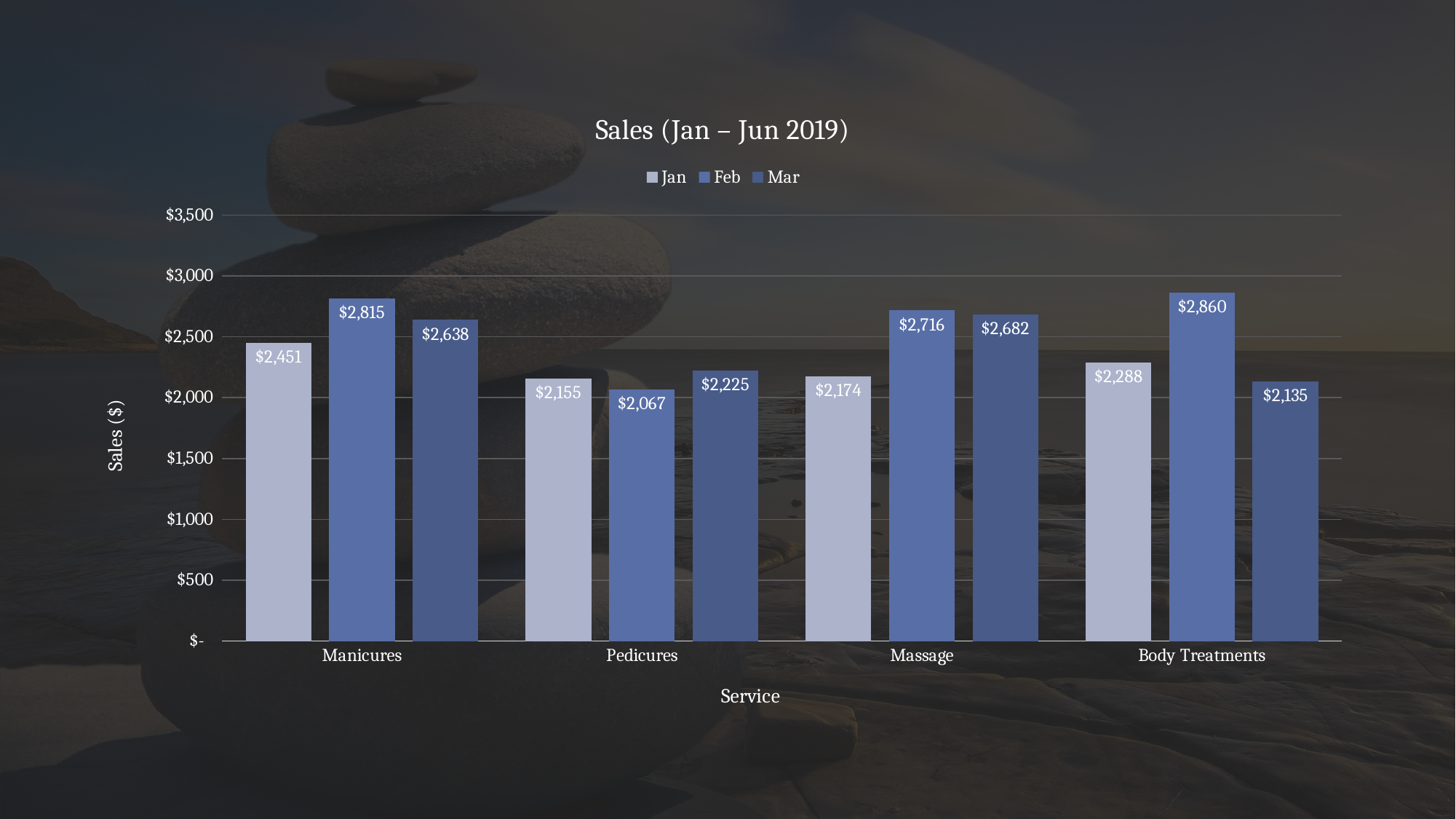
Is the Feb value for Pedicures greater or less than $2,500? less What were the Feb sales for Manicures? $2,815 Which service had the lowest Jan sales? Pedicures What were the Jan sales for Massage? $2,174 Which service had the highest Feb sales? Body Treatments How many service categories are shown on the x axis? 4 What were the Mar sales for Body Treatments? $2,135 What is the title of the chart? Sales (Jan – Jun 2019) What kind of chart is shown on the slide? Bar chart What is the difference between Feb and Jan sales for Manicures? $364 How many series does the legend list? 3 Which is larger: Mar sales for Massage or Mar sales for Pedicures? Mar sales for Massage